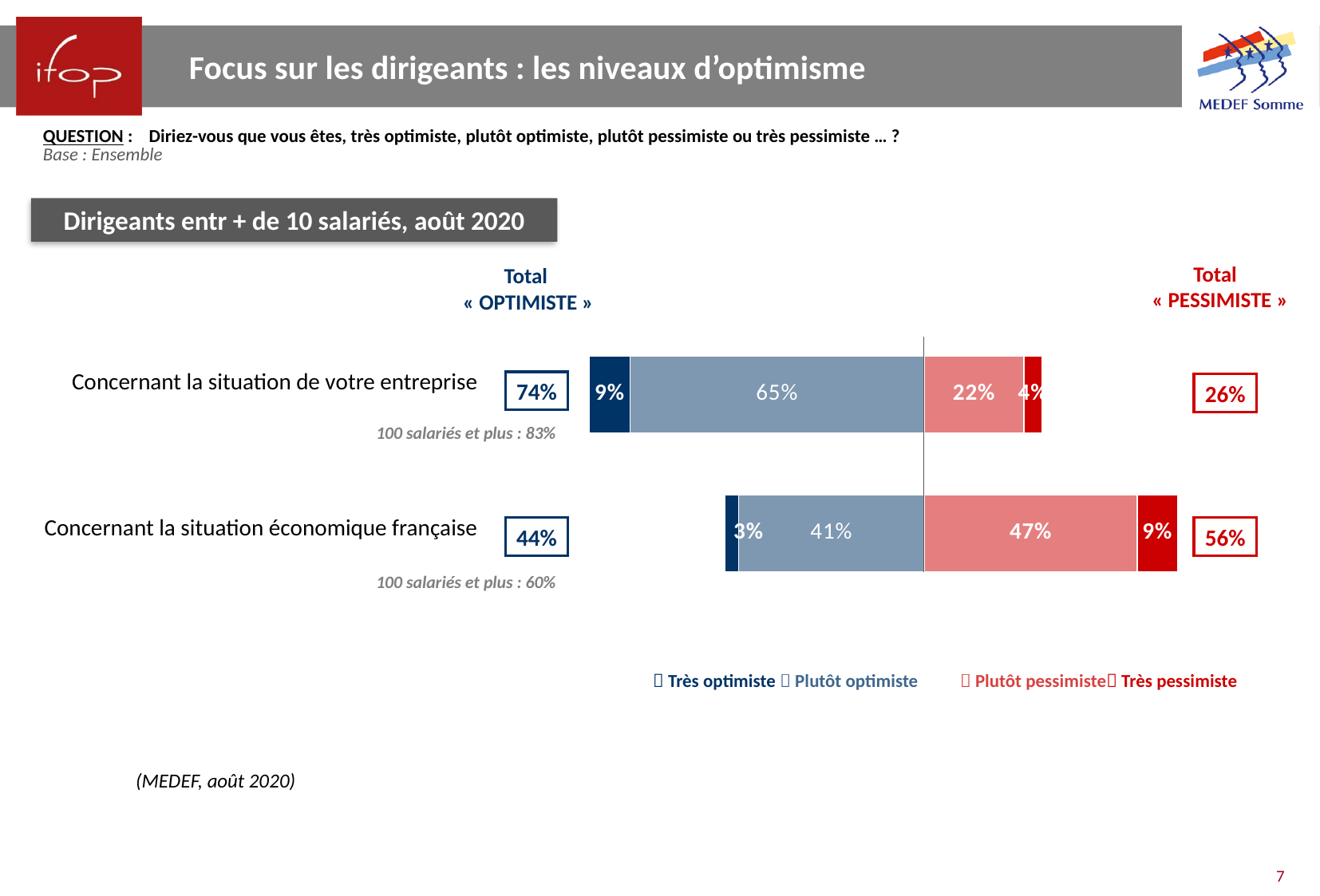
What is the difference between the "Plutôt optimiste" values for the company situation and the French economic situation? 24 percentage points What kind of chart is shown on the slide? Stacked bar chart How many series does the legend list? 4 What percentage of respondents are "Plutôt pessimiste" concerning the French economic situation ("Concernant la situation économique française")? 47% What is the "Très pessimiste" value for "Concernant la situation de votre entreprise"? 4% What percentage of respondents are "Plutôt optimiste" concerning the situation of their company ("Concernant la situation de votre entreprise")? 65% Which is larger: the "Très pessimiste" share for the company situation or for the French economic situation? French economic situation (9%) What is the Total "PESSIMISTE" for "Concernant la situation économique française"? 56% What is the Total "OPTIMISTE" for "Concernant la situation de votre entreprise"? 74% What is the "Très optimiste" value for "Concernant la situation économique française"? 3% How many categories (rows) are plotted in the chart? 2 What is the total of the "Très optimiste" and "Plutôt optimiste" segments for "Concernant la situation économique française"? 44%